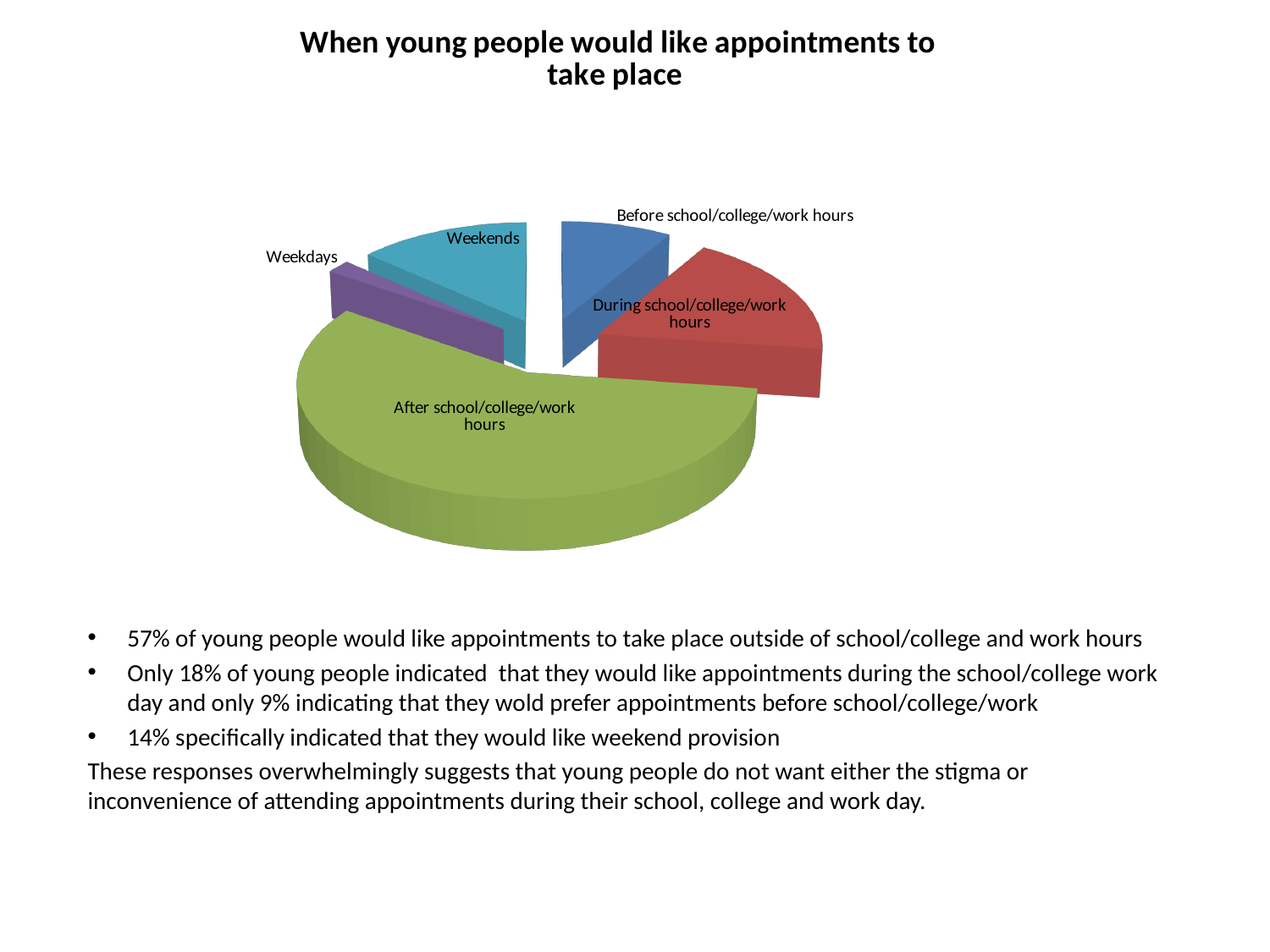
Which slice is larger: During school/college/work hours or Before school/college/work hours? During school/college/work hours Which slice is larger: After school/college/work hours or During school/college/work hours? After school/college/work hours Which slice is larger: Weekends or Weekdays? Weekends Which category has the largest slice of the pie? After school/college/work hours What colour is the slice for During school/college/work hours? Red What is the title of the chart? When young people would like appointments to take place What kind of chart is shown on the slide? Pie chart Which category has the smallest slice of the pie? Weekdays How many slices does the pie chart have? 5